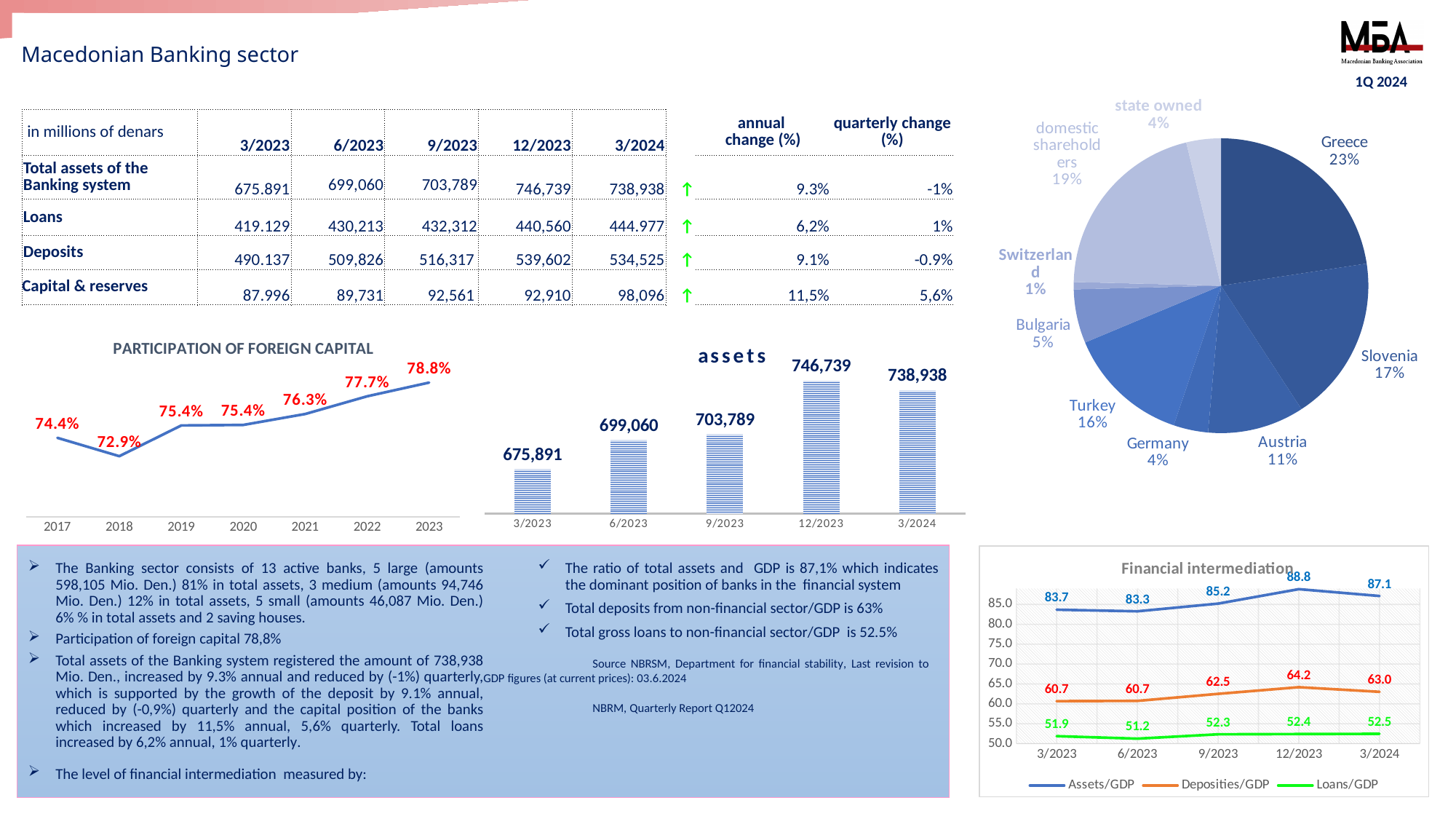
In the assets bar chart, what is the difference between the 3/2024 value and the 3/2023 value? 63,047 In the assets bar chart, which period has the highest value? 12/2023 In the pie chart, which is larger, Turkey or Austria? Turkey What kind of chart is the assets chart? Bar chart In the PARTICIPATION OF FOREIGN CAPITAL chart, what is the value for 2023? 78.8% In the PARTICIPATION OF FOREIGN CAPITAL chart, how many years are plotted? 7 In the PARTICIPATION OF FOREIGN CAPITAL chart, which year has the lowest value? 2018 In the pie chart, which slice is the smallest? Switzerland In the pie chart, what share does Greece have? 23% In the Financial intermediation chart, what is the Assets/GDP value for 12/2023? 88.8 How many series does the legend of the Financial intermediation chart list? 3 In the assets bar chart, what is the value for 12/2023? 746,739